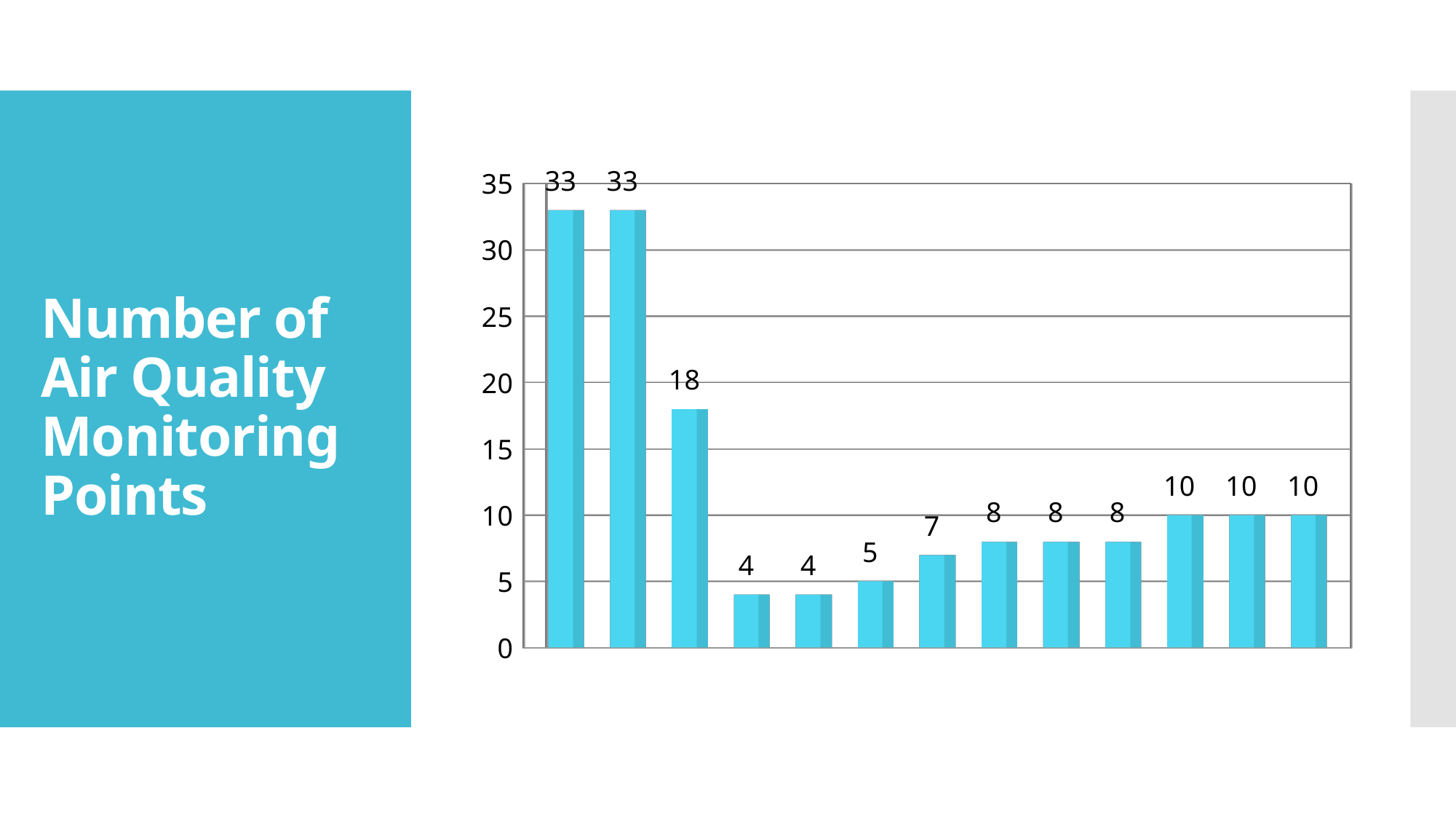
What is the value of the first bar from the left? 33 What is the difference between the value of the first bar (33) and the third bar (18)? 15 How many bars does the chart contain? 13 What is the value of the seventh bar from the left? 7 What is the highest value shown in the chart? 33 What is the value of the last bar on the right? 10 Is the value of the third bar from the left greater or less than 15? greater What kind of chart is shown on the slide? bar chart What is the value of the third bar from the left? 18 What is the lowest value shown in the chart? 4 Which is larger, the value of the sixth bar from the left or the value of the eighth bar from the left? the eighth bar What is the title shown on the slide for this chart? Number of Air Quality Monitoring Points